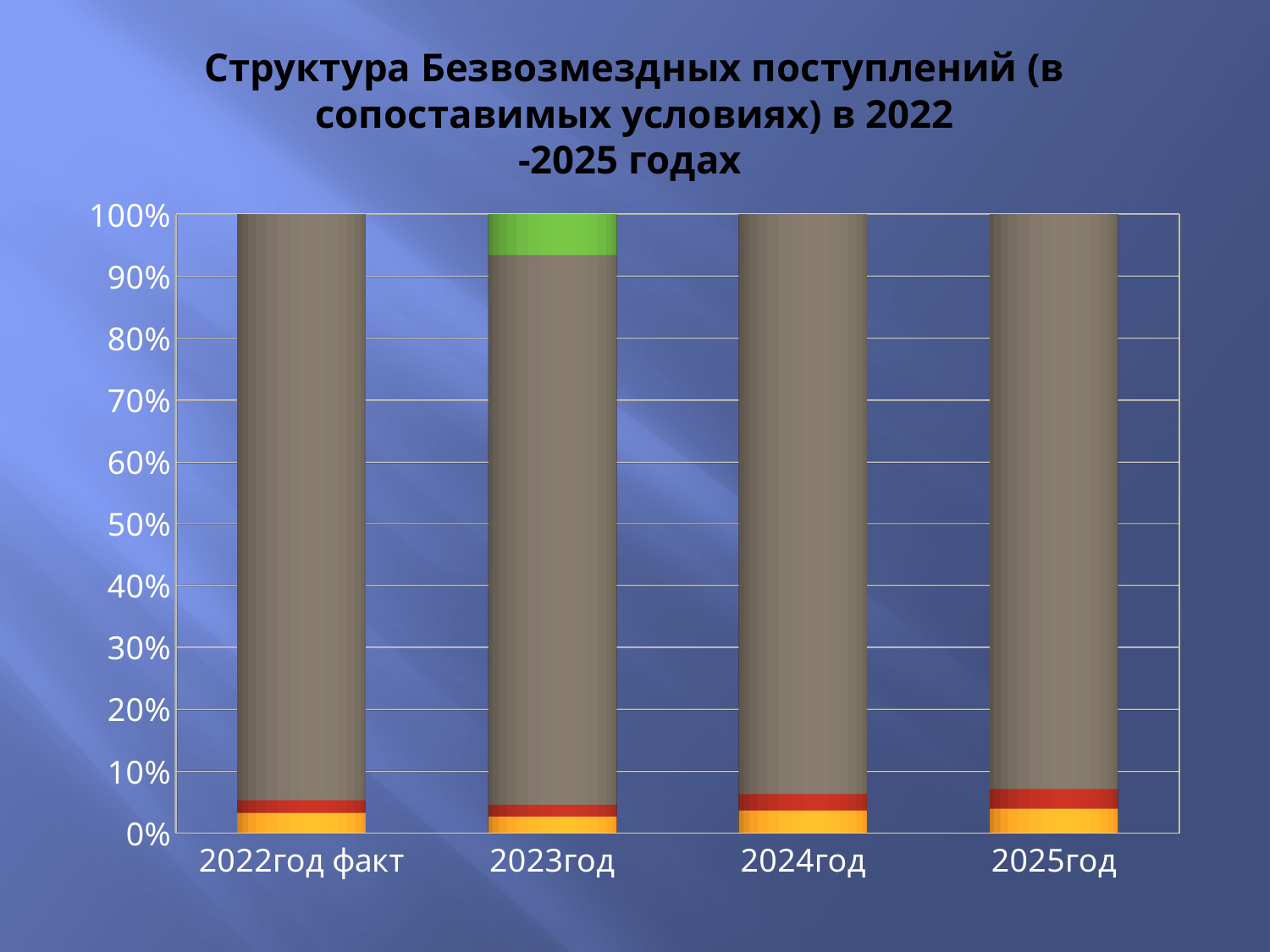
What is the total height of the stacked bar for 2022год факт? 100% What kind of chart is shown on the slide? Stacked bar chart Is the yellow segment of the 2024год bar greater or less than 10%? less Is the green segment of the 2023год bar greater or less than 10% of the bar? less Which category on the x axis includes a green segment at the top of its bar? 2023год What is the title of the chart on the slide? Структура Безвозмездных поступлений (в сопоставимых условиях) в 2022-2025 годах How many categories (years) are shown on the x axis of the chart? 4 Which category label on the x axis includes the word 'факт'? 2022год факт Is the top of the brown segment in the 2023год bar greater or less than 90%? greater What is the total height of the stacked bar for 2025год? 100% What is the highest value shown on the vertical axis of the chart? 100%